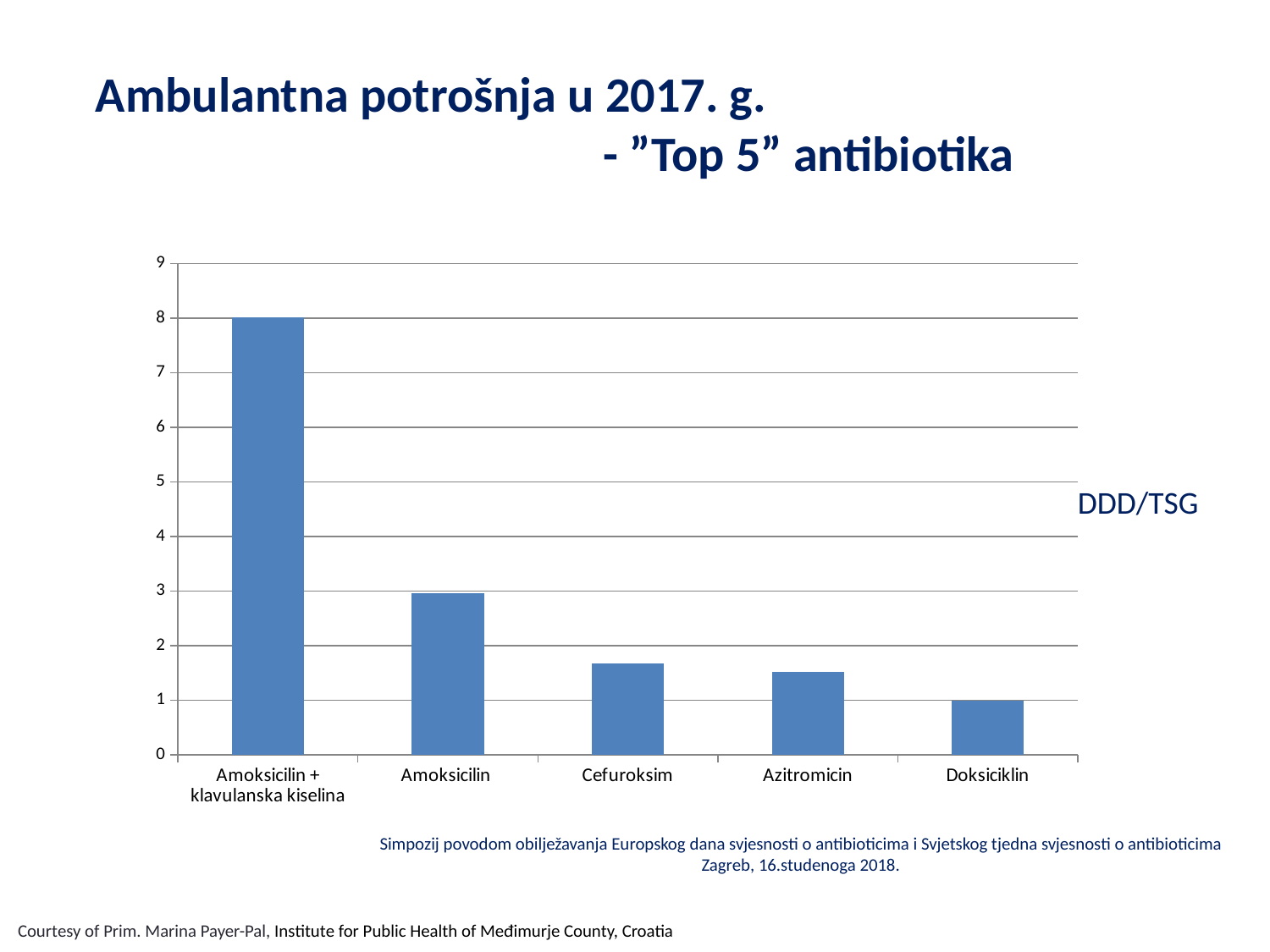
What kind of chart is shown on the slide? bar chart Which antibiotic has the highest value in the chart? Amoksicilin + klavulanska kiselina Is the value for Amoksicilin greater or less than 2? greater Is the value for Azitromicin greater or less than 1? greater Which has a larger value, Amoksicilin or Cefuroksim? Amoksicilin Which antibiotic has the lowest value in the chart? Doksiciklin Is the value for Cefuroksim greater or less than 2? less What is the value for Amoksicilin + klavulanska kiselina? 8 How many antibiotics are shown on the x axis of the chart? 5 Do the values rise or fall from left to right along the x axis? fall What unit label is shown next to the chart? DDD/TSG